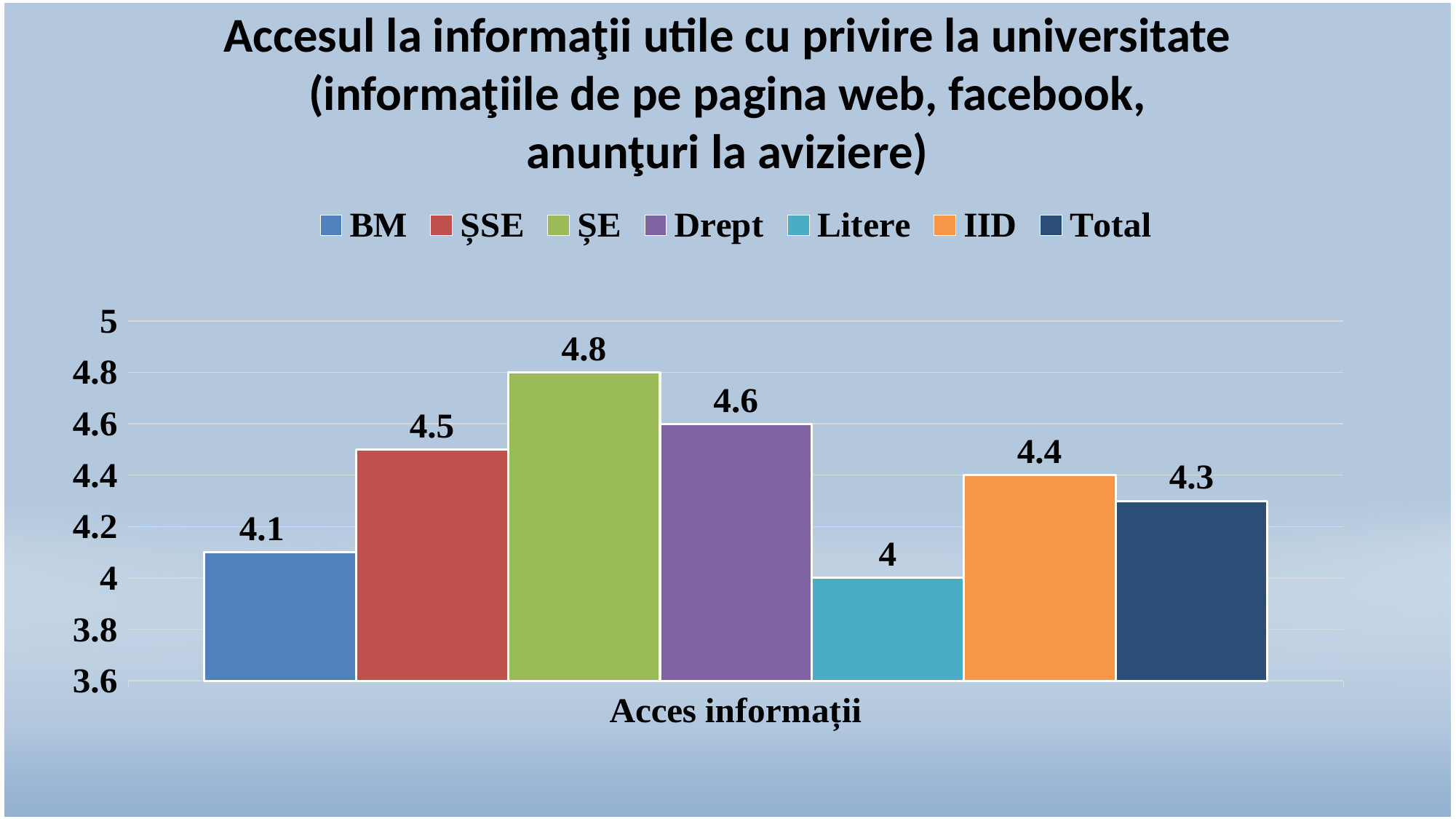
Which is larger, the value for ȘSE or the value for IID? ȘSE What is the value for Litere? 4 What kind of chart is shown on the slide? bar chart Which series has the lowest value? Litere What is the difference between the values for Drept and IID? 0.2 How many series does the legend list? 7 What is the label on the x axis of the chart? Acces informații What is the value for ȘE? 4.8 What is the value for Total? 4.3 What is the difference between the values for ȘE and BM? 0.7 Which series has the highest value? ȘE Is the value for BM greater or less than 4.2? less